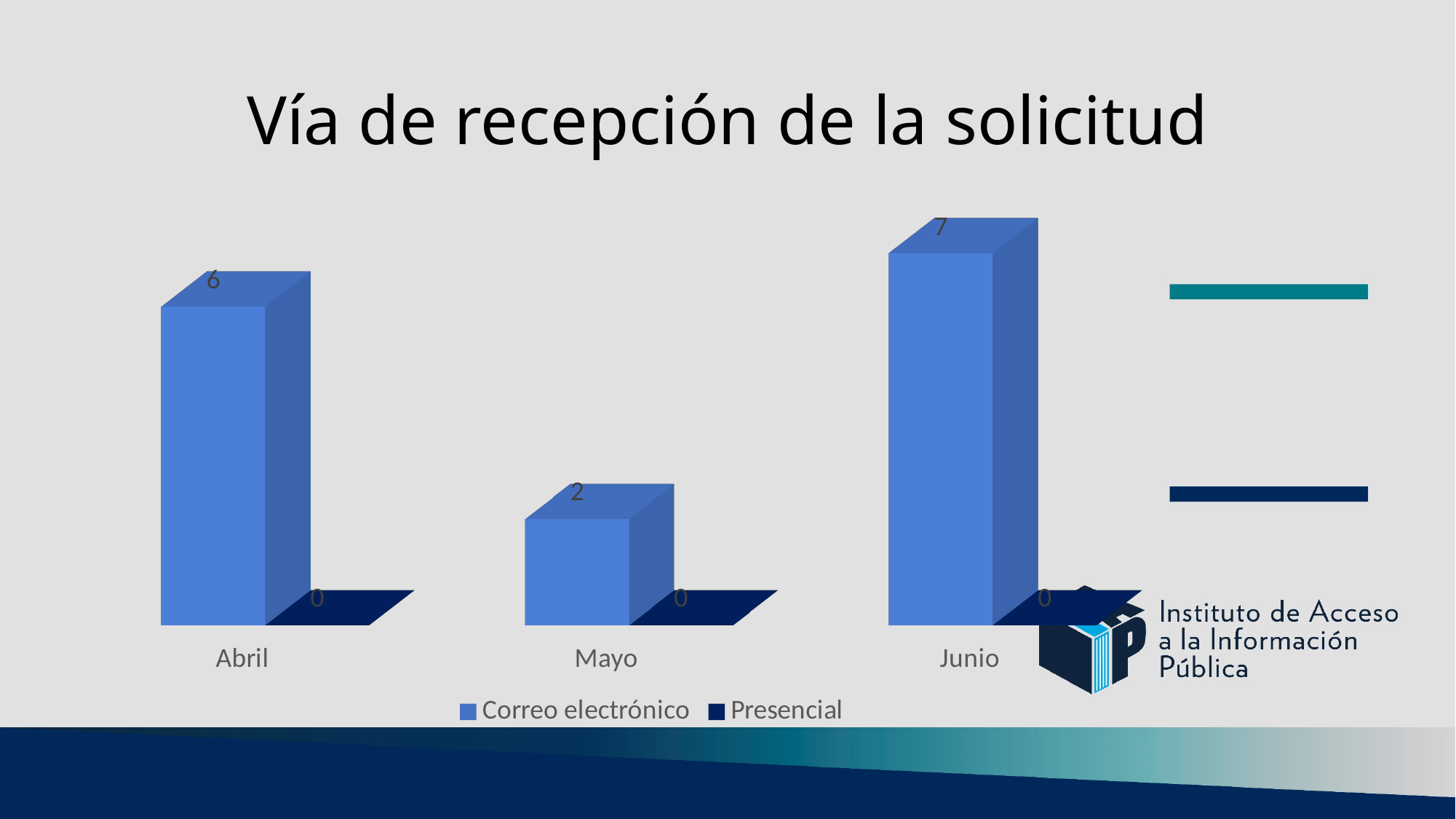
What is the value for Presencial in Mayo? 0 Which month has the highest value for Correo electrónico? Junio What is the value for Correo electrónico in Abril? 6 What kind of chart is shown on the slide? Bar chart What is the difference between the Correo electrónico values for Junio and Mayo? 5 How many months are shown on the x axis? 3 What is the title of the chart? Vía de recepción de la solicitud How many series does the legend list? 2 Which month has the lowest value for Correo electrónico? Mayo What is the value for Correo electrónico in Junio? 7 What is the value for Correo electrónico in Mayo? 2 Which is larger, the Correo electrónico value for Abril or for Junio? Junio